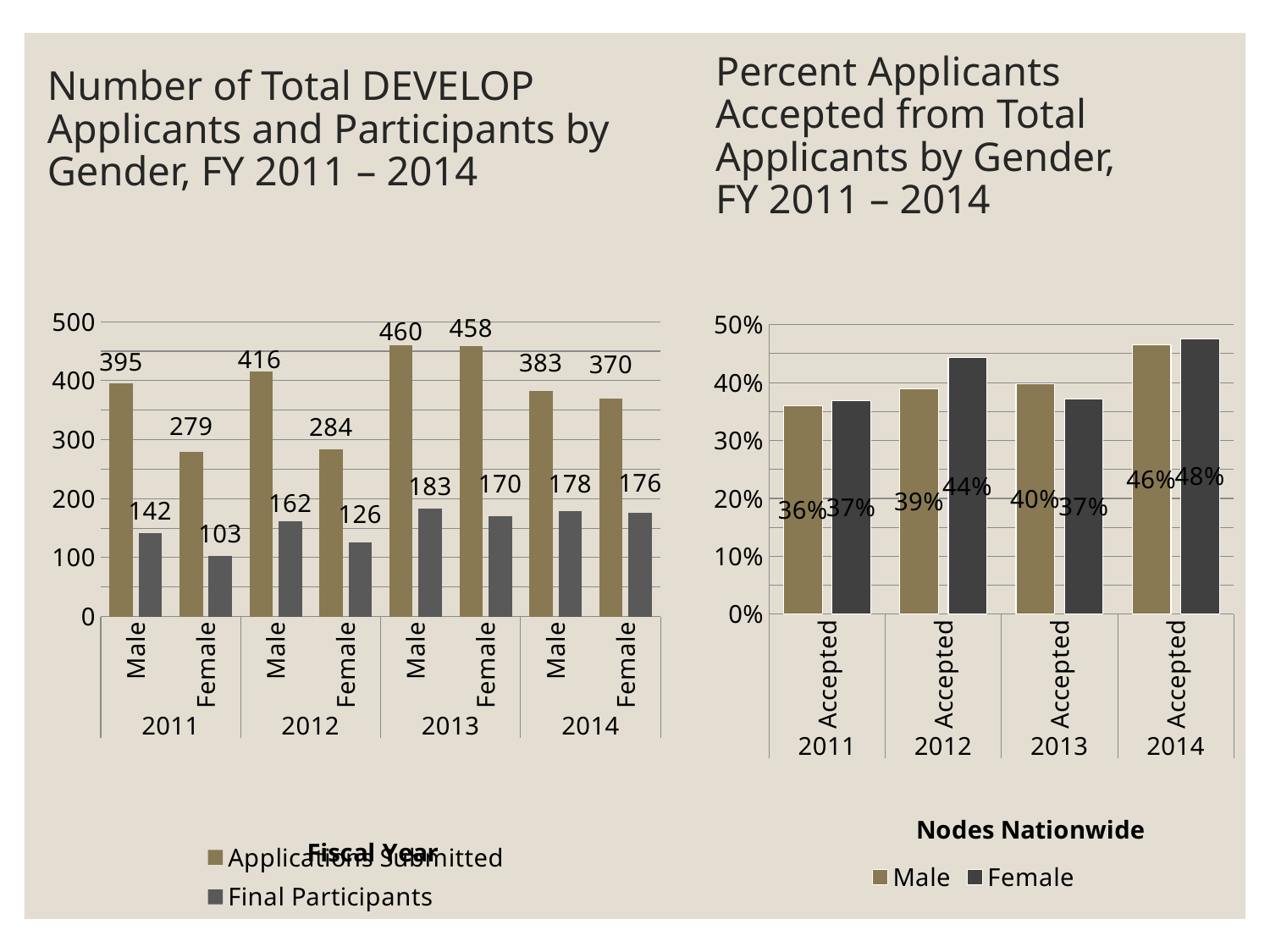
In the left chart, how many final participants were female in FY 2011? 103 In the left chart, which category has the highest number of applications submitted? Male 2013 In the left chart, which is larger: applications submitted by females in 2012 or by females in 2014? Females in 2014 In the right chart, is the percent of female applicants accepted in 2014 greater or less than 40%? greater In the right chart, what percent of female applicants were accepted in FY 2012? 44% In the left chart, what is the difference between applications submitted and final participants for males in FY 2012? 254 What kind of chart is the right chart? Bar chart In the left chart, which category has the lowest number of final participants? Female 2011 In the left chart, how many applications were submitted by males in FY 2013? 460 In the left chart, how many series does the legend list? 2 In the right chart, what is the difference between the female and male acceptance percentages in FY 2013? 3% In the right chart, which year has the highest percent of male applicants accepted? 2014